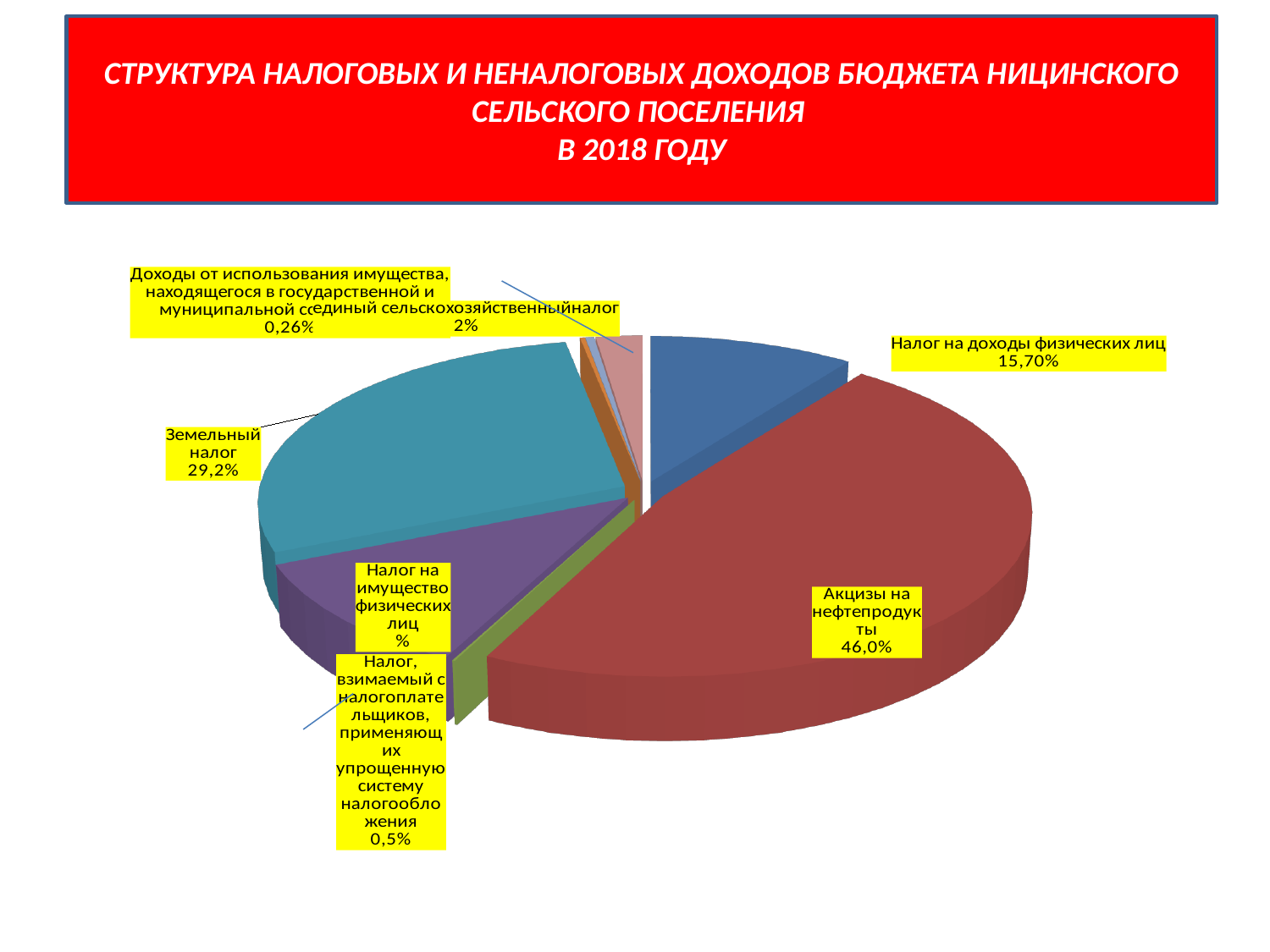
What share is shown for Налог на доходы физических лиц? 15,70% Which revenue source has the smallest share of the pie? Доходы от использования имущества, находящегося в государственной и муниципальной собственности What kind of chart is shown on the slide? pie chart What share is shown for Земельный налог? 29,2% Which revenue source has the largest share of the pie? Акцизы на нефтепродукты How many slices does the pie chart have? 8 What share is shown for Налог, взимаемый с налогоплательщиков, применяющих упрощенную систему налогообложения? 0,5% What share is shown for Единый сельскохозяйственный налог? 2% What share is shown for Доходы от использования имущества, находящегося в государственной и муниципальной собственности? 0,26% Which is larger: the share of Земельный налог or the share of Налог на доходы физических лиц? Земельный налог By how many percentage points does the share of Акцизы на нефтепродукты exceed the share of Земельный налог? 16,8% What share of the budget revenue comes from Акцизы на нефтепродукты? 46,0%